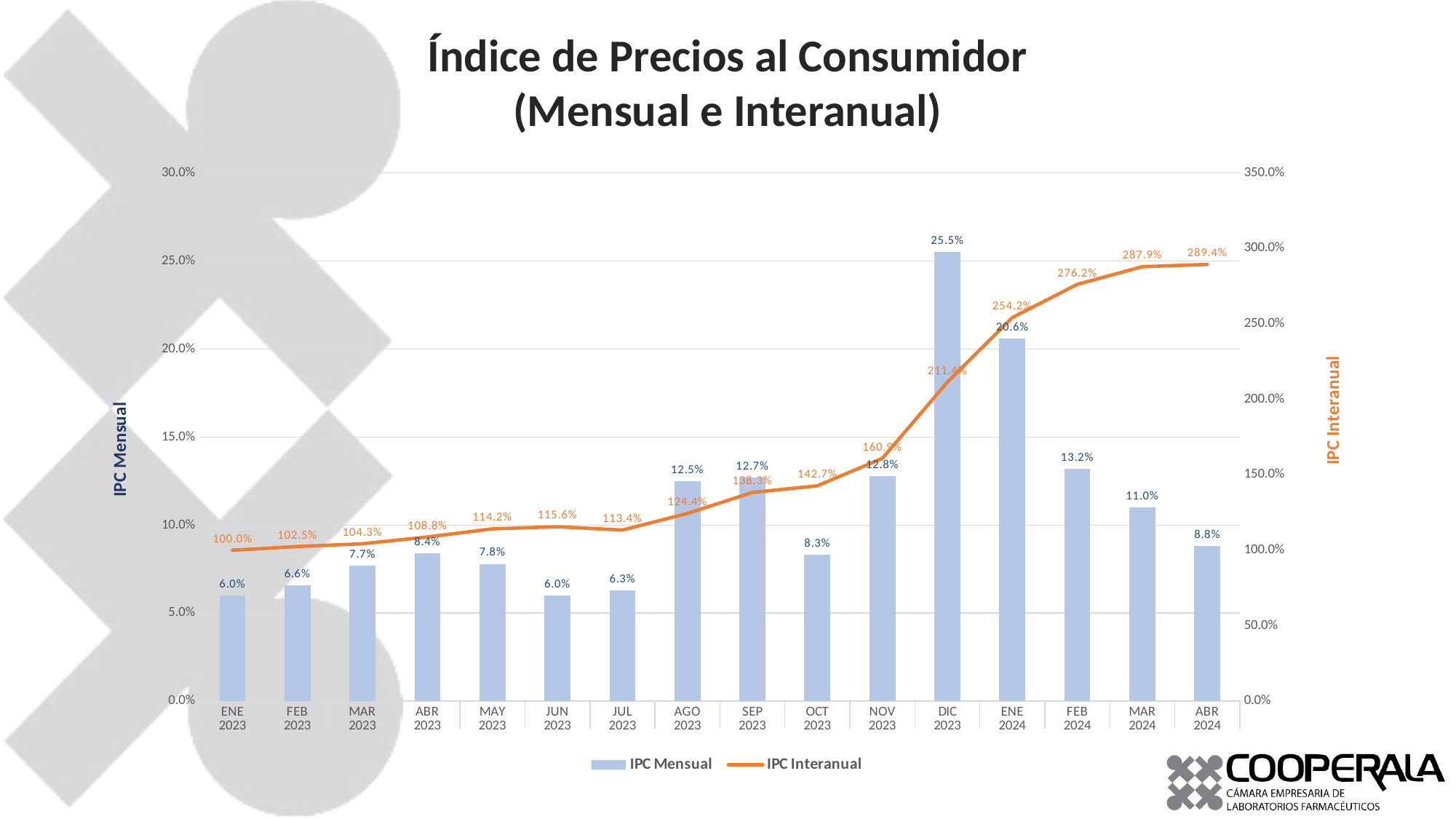
Does the IPC Interanual line generally rise or fall from ENE 2023 to ABR 2024? Rise How many series does the legend list? 2 Which month has the highest IPC Mensual value? DIC 2023 What kind of chart is this? Combined bar and line chart What is the difference between the IPC Mensual values for DIC 2023 and ENE 2024? 4.9% What is the IPC Interanual value for ABR 2024? 289.4% Which month has the lowest IPC Interanual value? ENE 2023 Which is larger, the IPC Mensual value for FEB 2024 or for MAR 2024? FEB 2024 What is the IPC Interanual value for ENE 2023? 100.0% What is the IPC Mensual value for AGO 2023? 12.5% What is the IPC Mensual value for DIC 2023? 25.5% How many months are shown on the x axis? 16